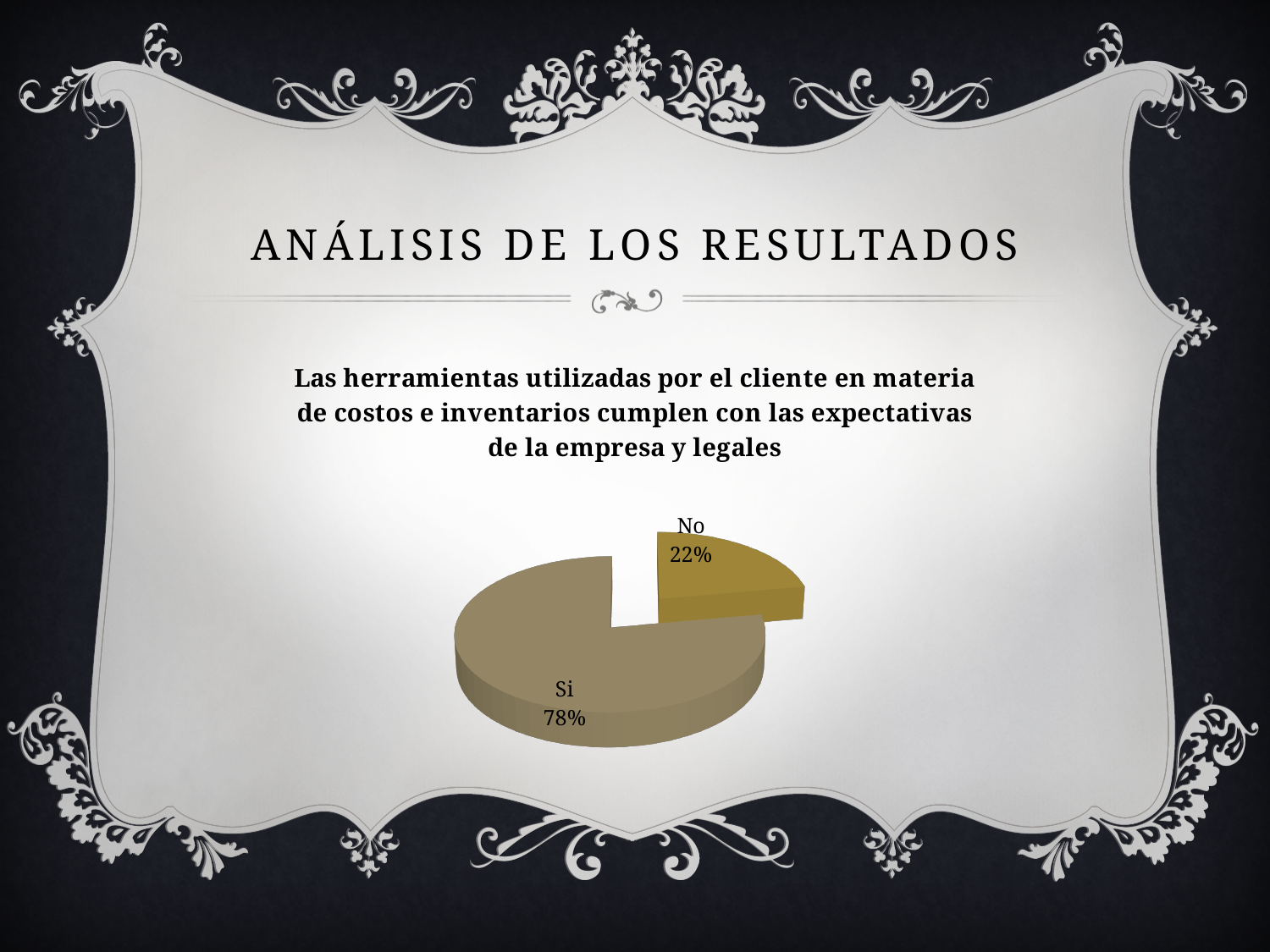
What is the title of the slide containing the pie chart? Análisis de los resultados Which slice of the pie is the smallest? No What share of the pie does the "No" slice represent? 22% How many slices does the pie chart have? 2 What is the difference in percentage points between the "Si" and "No" slices? 56 Which slice of the pie is the largest? Si What kind of chart is shown on the slide? Pie chart Which slice of the pie is pulled out (exploded) from the rest? No What percentage of the pie is labelled "No"? 22% What percentage of the pie is labelled "Si"? 78% Which is larger, the "Si" slice or the "No" slice? Si